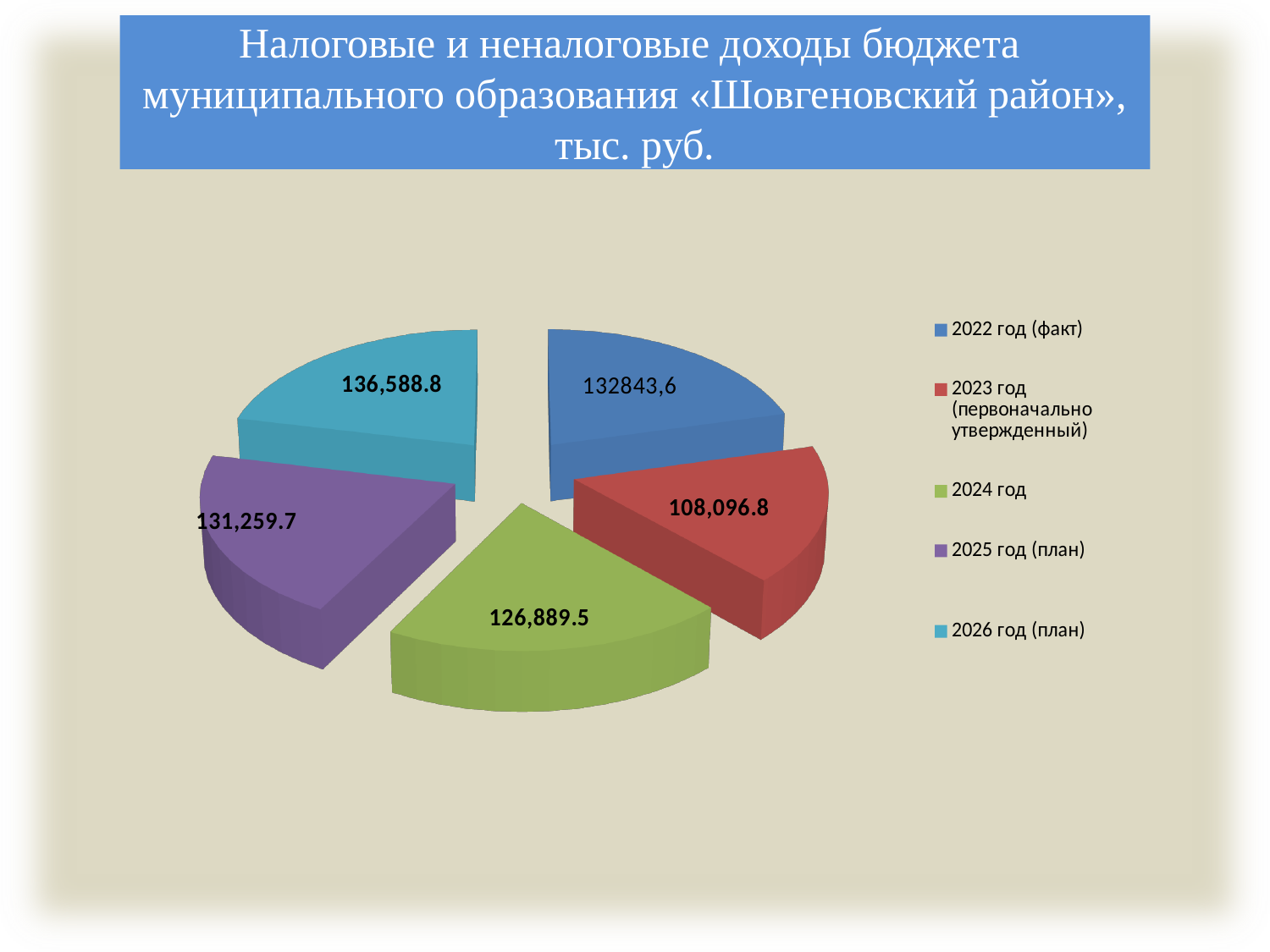
What colour is the slice for 2025 год (план)? Purple What is the difference between the values for 2024 год and 2023 год (первоначально утвержденный)? 18,792.7 How many slices does the pie chart have? 5 What is the value for 2023 год (первоначально утвержденный)? 108,096.8 Which year has the highest value in the pie chart? 2026 год (план) What kind of chart is shown on the slide? Pie chart Which year has the lowest value in the pie chart? 2023 год (первоначально утвержденный) What is the value for 2022 год (факт)? 132843,6 What is the difference between the values for 2026 год (план) and 2025 год (план)? 5,329.1 Which is larger, the value for 2025 год (план) or the value for 2024 год? 2025 год (план) What is the value for 2026 год (план)? 136,588.8 What is the value for 2024 год? 126,889.5